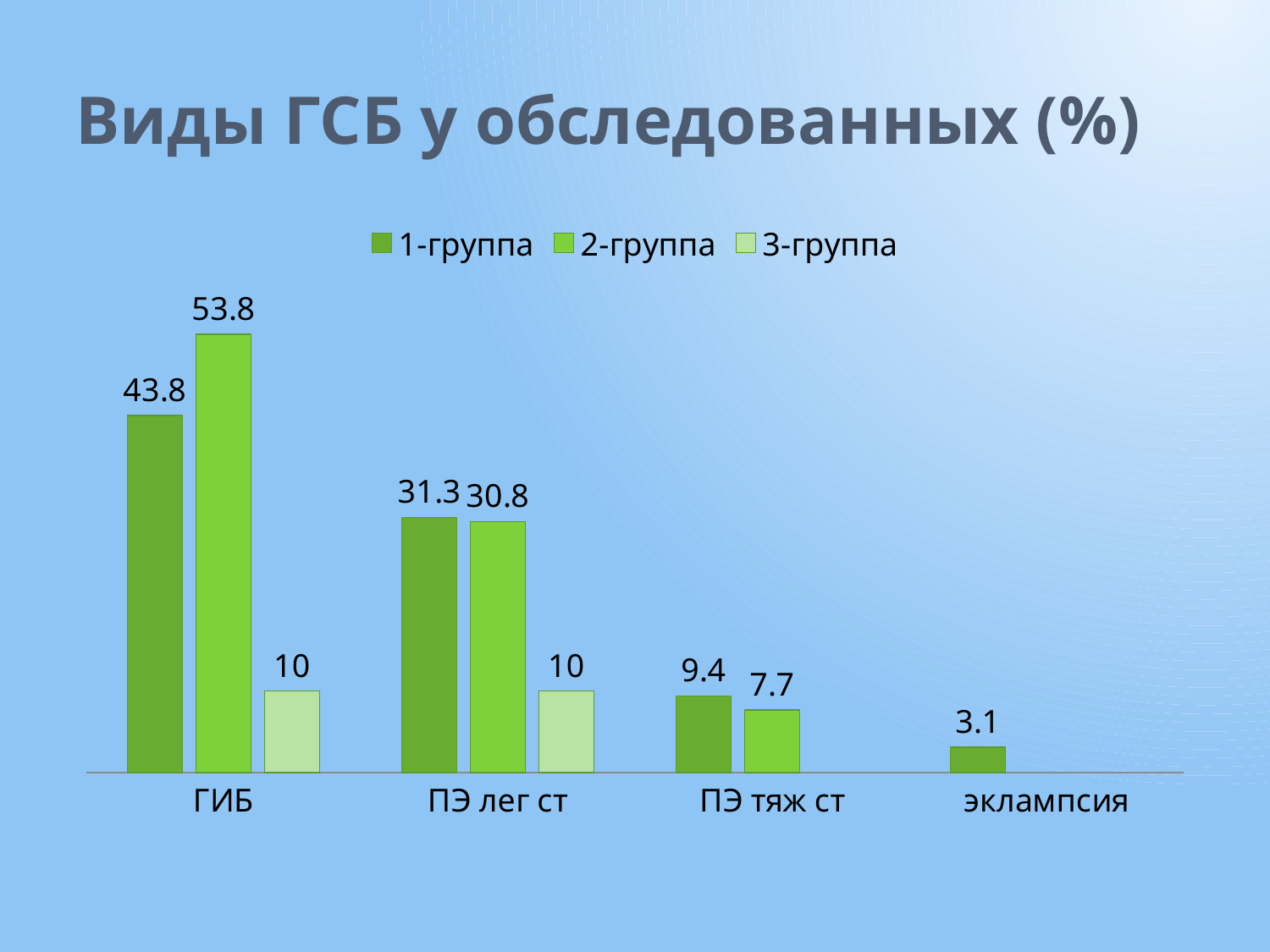
How many series does the legend list? 3 How many categories are shown on the x axis? 4 What is the value for 3-группа in the ПЭ лег ст category? 10 Which category has the highest value for 1-группа? ГИБ What is the title of the chart? Виды ГСБ у обследованных (%) Which is larger in the ПЭ тяж ст category: 1-группа or 2-группа? 1-группа What is the value for 2-группа in the ГИБ category? 53.8 Which category has the lowest value for 1-группа? эклампсия What is the value for 1-группа in the ПЭ тяж ст category? 9.4 What kind of chart is shown on the slide? Bar chart What is the difference between the 2-группа and 1-группа values in the ГИБ category? 10 What is the value for 1-группа in the эклампсия category? 3.1